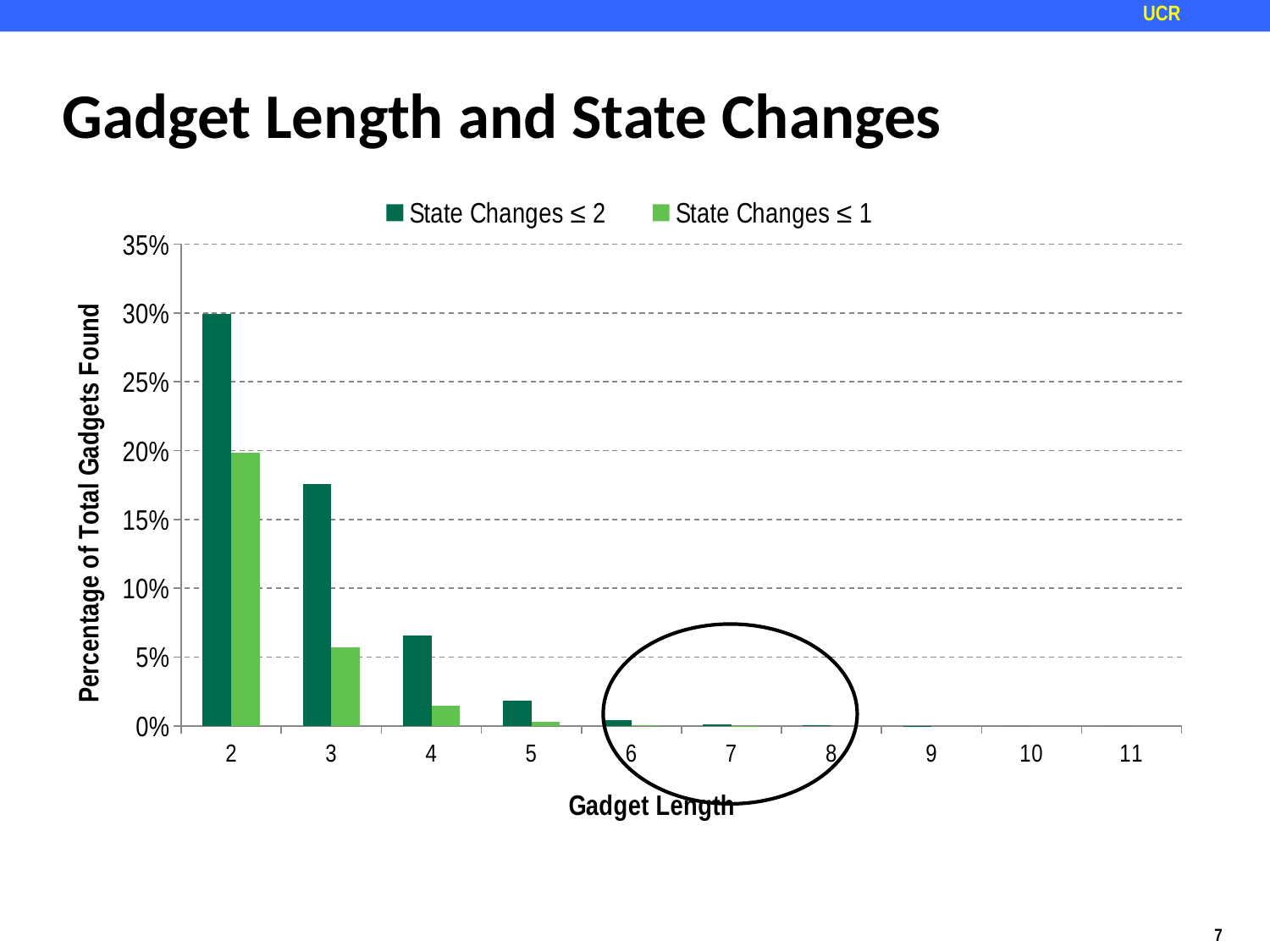
How many gadget length categories are shown on the x axis? 10 What is the title of the y axis? Percentage of Total Gadgets Found For the State Changes ≤ 2 series, which gadget length has the highest percentage? 2 How many series does the legend list? 2 Is the State Changes ≤ 2 value for gadget length 4 greater or less than 5%? greater For the State Changes ≤ 1 series, which gadget length has the highest percentage? 2 Is the State Changes ≤ 1 value for gadget length 2 greater or less than 15%? greater Do the percentages rise or fall as gadget length increases along the x axis? fall At gadget length 3, which series has the larger value: State Changes ≤ 2 or State Changes ≤ 1? State Changes ≤ 2 What kind of chart is shown on the slide? bar chart Is the State Changes ≤ 1 value for gadget length 3 greater or less than 10%? less